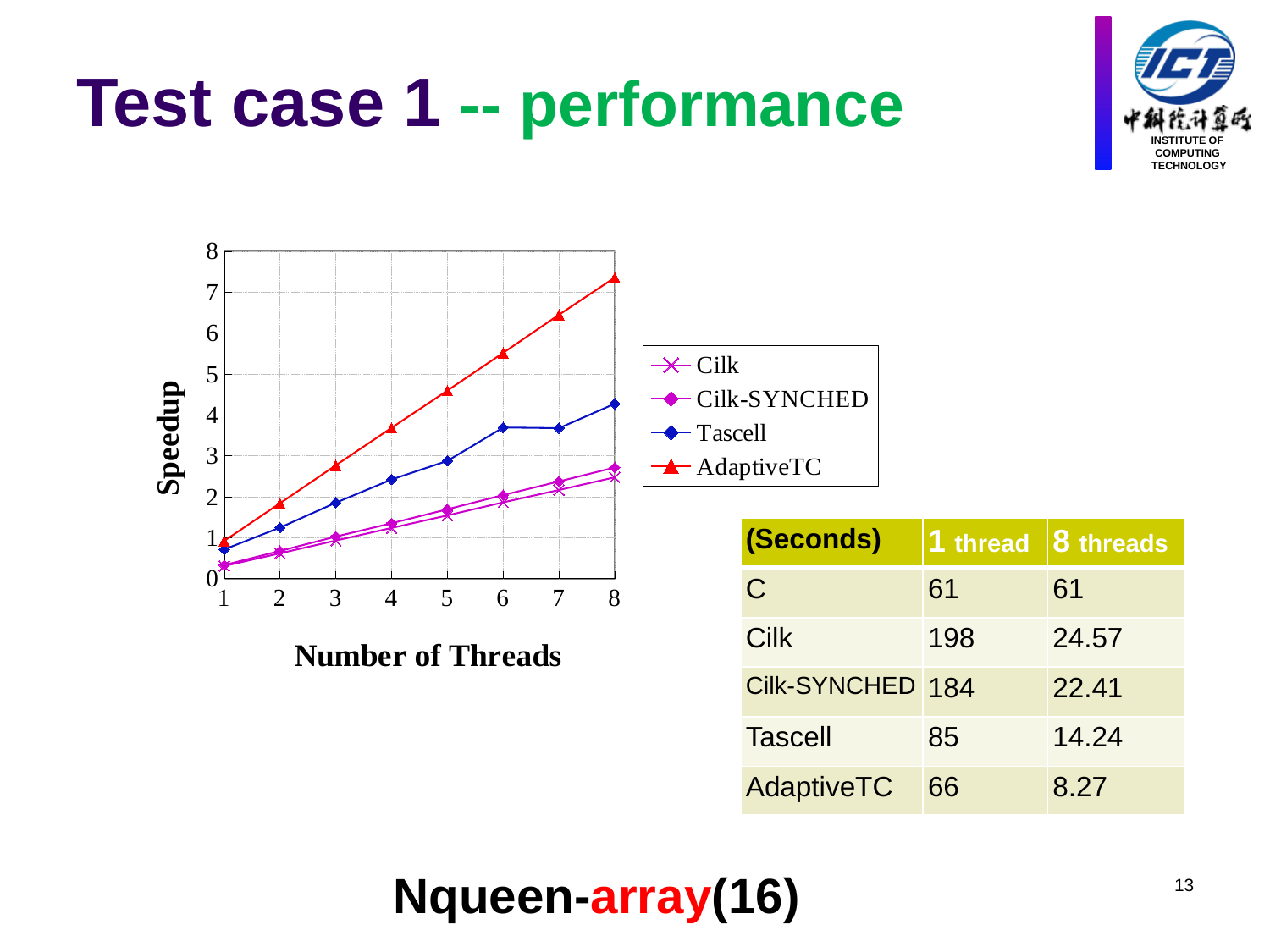
What is the title of the chart's x axis? Number of Threads Is the speedup for Cilk at 8 threads greater or less than 3? less Is the speedup for AdaptiveTC at 8 threads greater or less than 7? greater What kind of chart is shown on the slide? line chart Is the speedup for Tascell at 8 threads greater or less than 4? greater Which series has the highest speedup at 8 threads? AdaptiveTC Which series has the larger speedup at 6 threads, Tascell or AdaptiveTC? AdaptiveTC How many series does the chart legend list? 4 How many thread counts are plotted along the x axis of the chart? 8 Does the speedup for AdaptiveTC rise or fall as the number of threads increases? rise